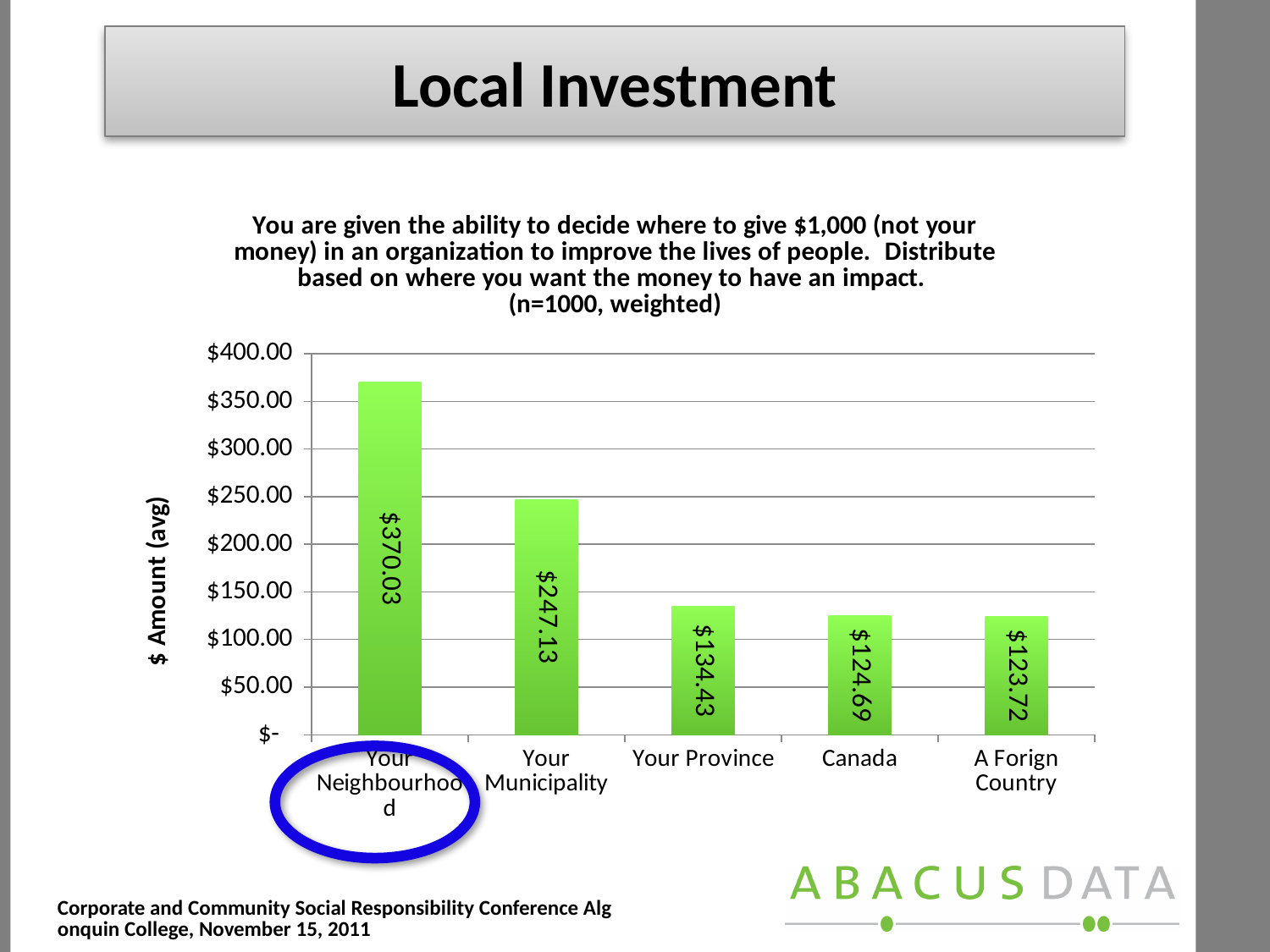
What kind of chart is shown on the slide? bar chart Which category has the highest value? Your Neighbourhood Do the values rise or fall from left to right along the x axis? fall What is the difference between the values for Your Neighbourhood and Your Municipality? $122.90 What is the value for Your Neighbourhood? $370.03 Is the value for Your Province greater or less than $150.00? less What is the value for Your Province? $134.43 Which is larger, the value for Your Municipality or the value for Your Province? Your Municipality How many categories are shown on the x axis? 5 What is the value for Canada? $124.69 What is the value for Your Municipality? $247.13 What is the difference between the values for Your Municipality and Your Province? $112.70